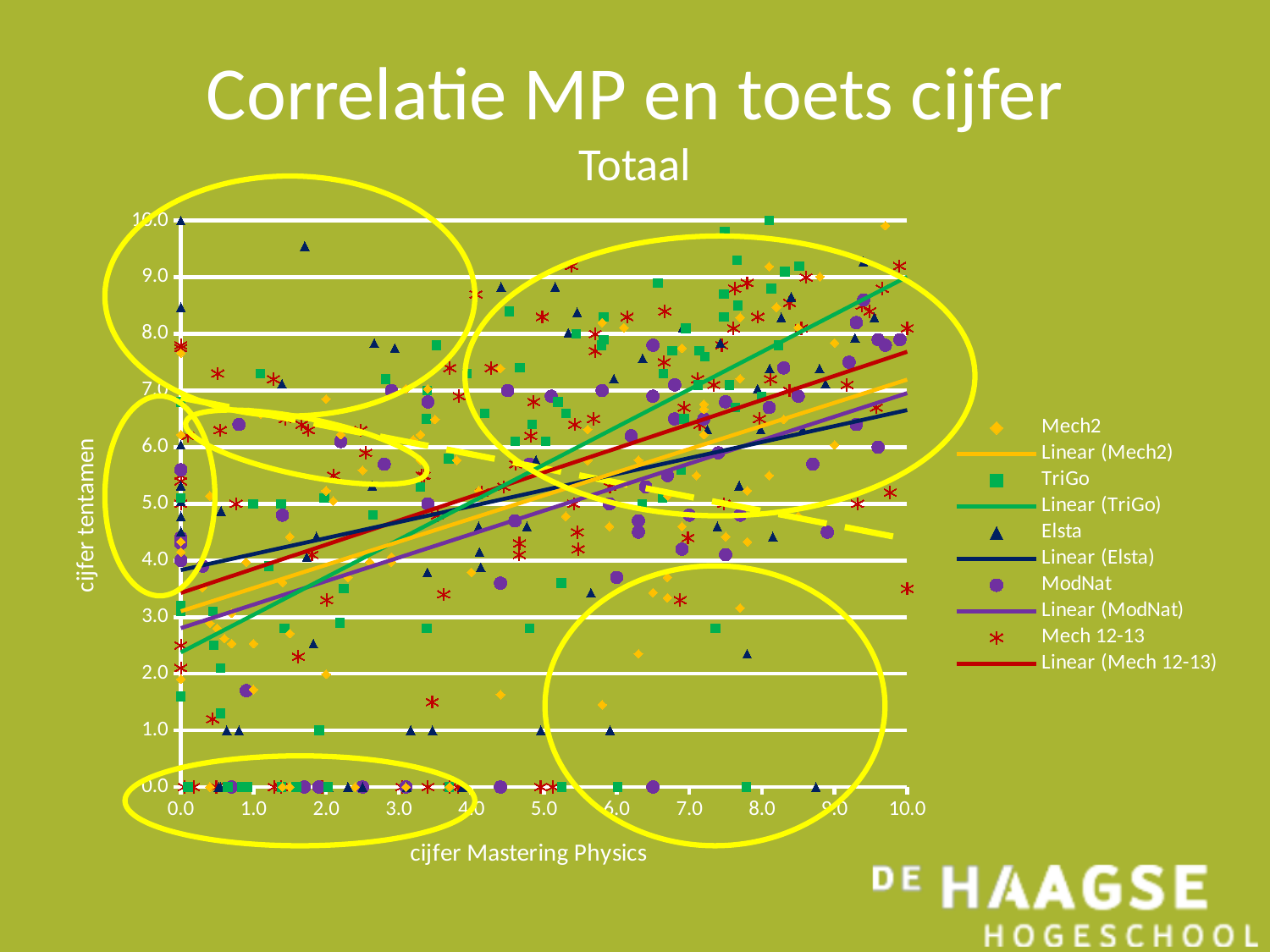
Which trend line is higher at x = 10.0: Linear (TriGo) or Linear (Elsta)? Linear (TriGo) What is the label of the horizontal axis? cijfer Mastering Physics What is the highest value shown on the vertical axis? 10.0 How many entries does the chart legend list? 10 Is the Linear (Elsta) trend line at x = 0.0 greater or less than 5.0? less Which series is plotted with red asterisk markers? Mech 12-13 Is the Linear (TriGo) trend line at x = 10.0 greater or less than 8.0? greater What is the highest value shown on the horizontal axis? 10.0 Do the linear trend lines rise or fall as the x-axis value increases? rise What kind of chart is shown on the slide? scatter chart Which series has the steepest linear trend line? TriGo What is the title shown directly above the chart? Totaal